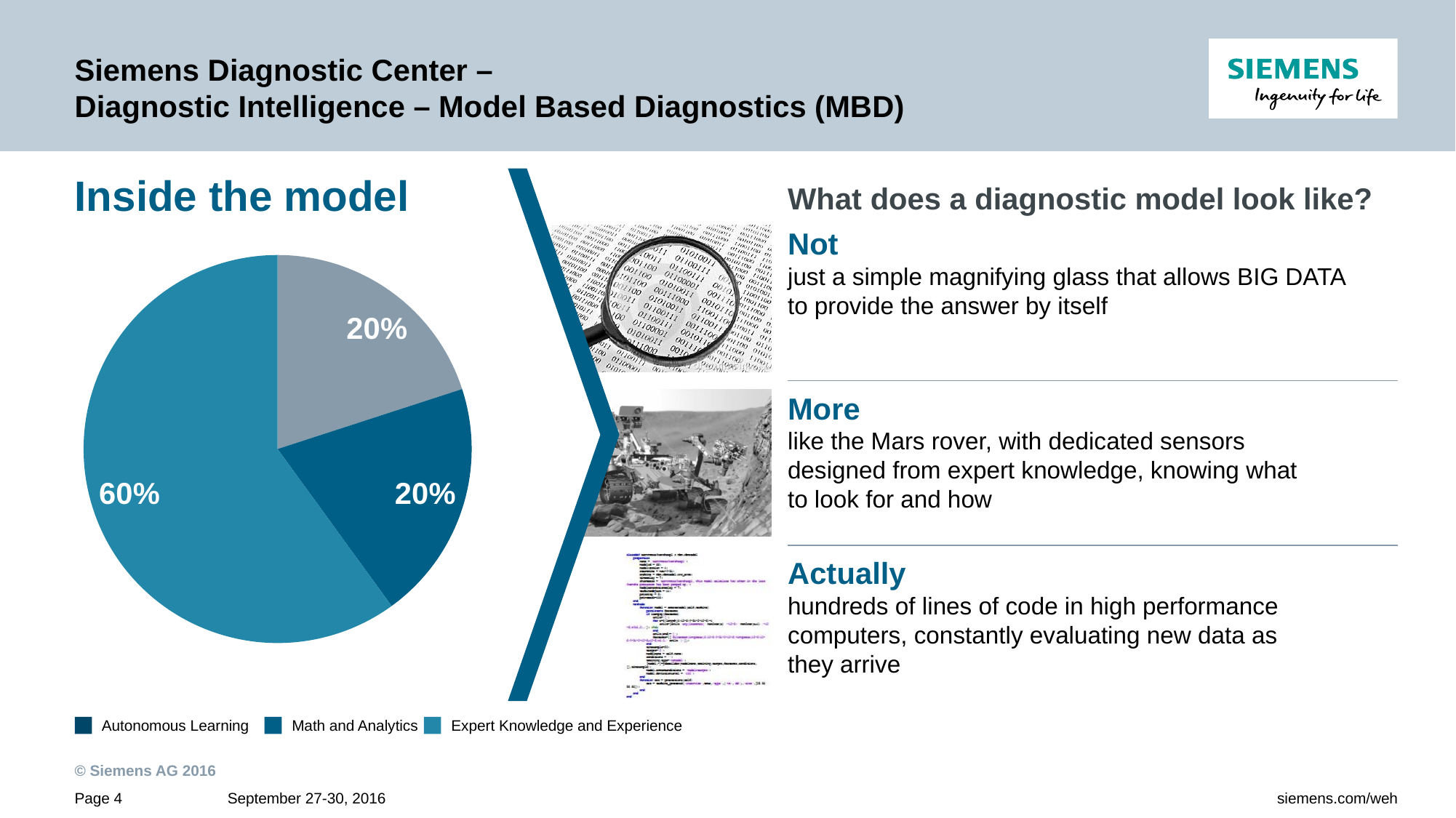
Which is larger in the pie chart: Expert Knowledge and Experience or Math and Analytics? Expert Knowledge and Experience What do the Autonomous Learning and Math and Analytics slices add up to? 40% Which category has the largest slice in the pie chart? Expert Knowledge and Experience How many slices does the pie chart have? 3 How many entries does the legend of the pie chart list? 3 What is the heading above the pie chart? Inside the model By how many percentage points is the Expert Knowledge and Experience slice larger than the Math and Analytics slice? 40 percentage points What percentage does the pie chart show for Math and Analytics? 20% What percentage does the pie chart show for Expert Knowledge and Experience? 60% What percentage does the pie chart show for Autonomous Learning? 20% What kind of chart is shown under the heading "Inside the model"? pie chart What share of the pie does the largest slice represent? 60%